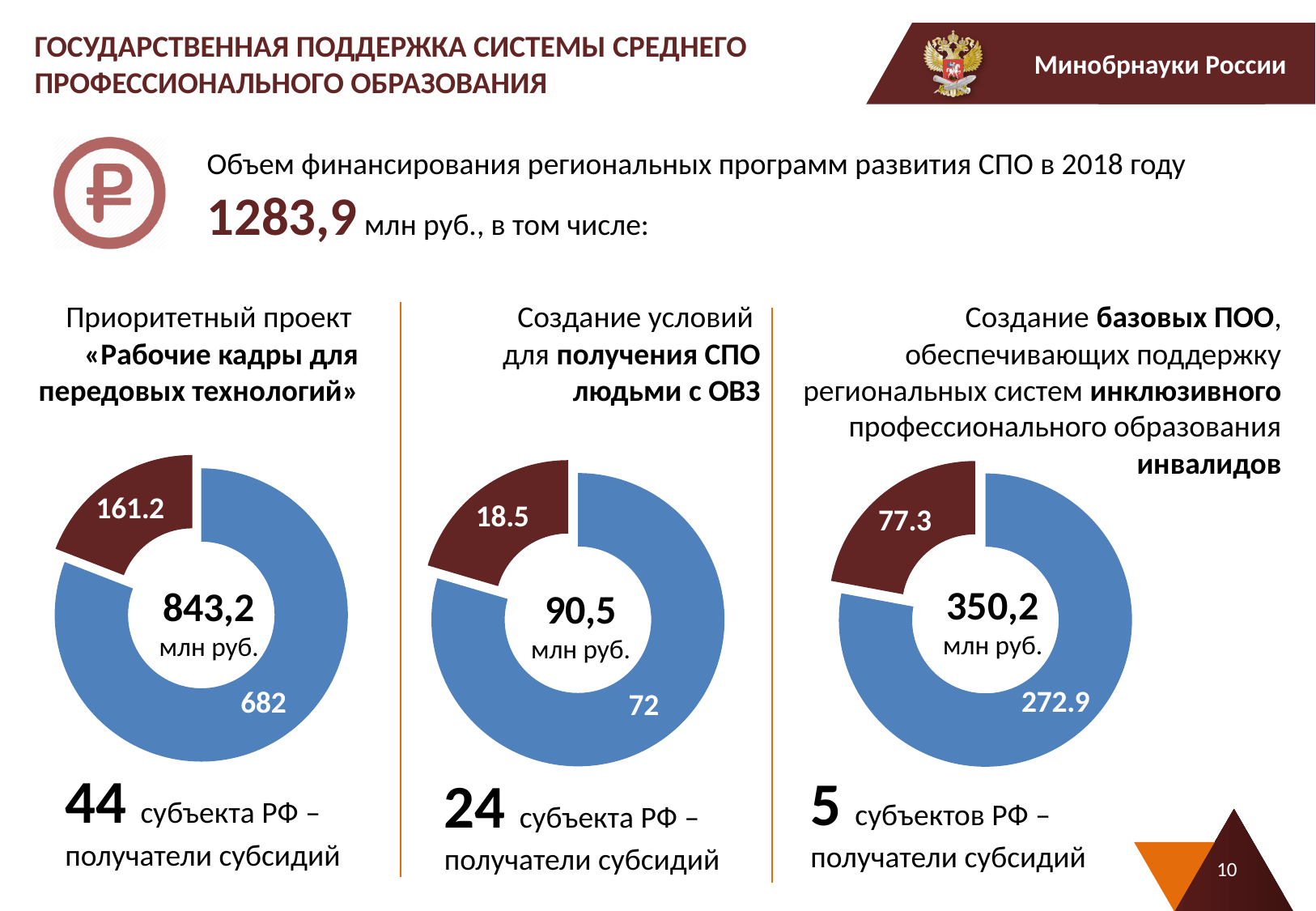
In the left chart (Приоритетный проект «Рабочие кадры для передовых технологий»), what value is printed on the blue segment? 682 What kind of chart is used on this slide? pie chart (donut) In the right chart (Создание базовых ПОО), what value is printed on the blue segment? 272.9 In the middle chart (Создание условий для получения СПО людьми с ОВЗ), what value is printed on the dark red segment? 18.5 In the left chart (Приоритетный проект «Рабочие кадры для передовых технологий»), what total is shown in the centre of the donut? 843,2 млн руб. In the middle chart (Создание условий для получения СПО людьми с ОВЗ), what total is shown in the centre of the donut? 90,5 млн руб. In the middle chart (Создание условий для получения СПО людьми с ОВЗ), what value is printed on the blue segment? 72 In the right chart (Создание базовых ПОО), what value is printed on the dark red segment? 77.3 In the middle chart (Создание условий для получения СПО людьми с ОВЗ), which segment is larger, the blue one or the dark red one? blue How many segments does each donut chart on the slide have? 2 In the left chart (Приоритетный проект «Рабочие кадры для передовых технологий»), what value is printed on the dark red segment? 161.2 In the right chart (Создание базовых ПОО), what is the difference between the blue segment value and the dark red segment value? 195.6